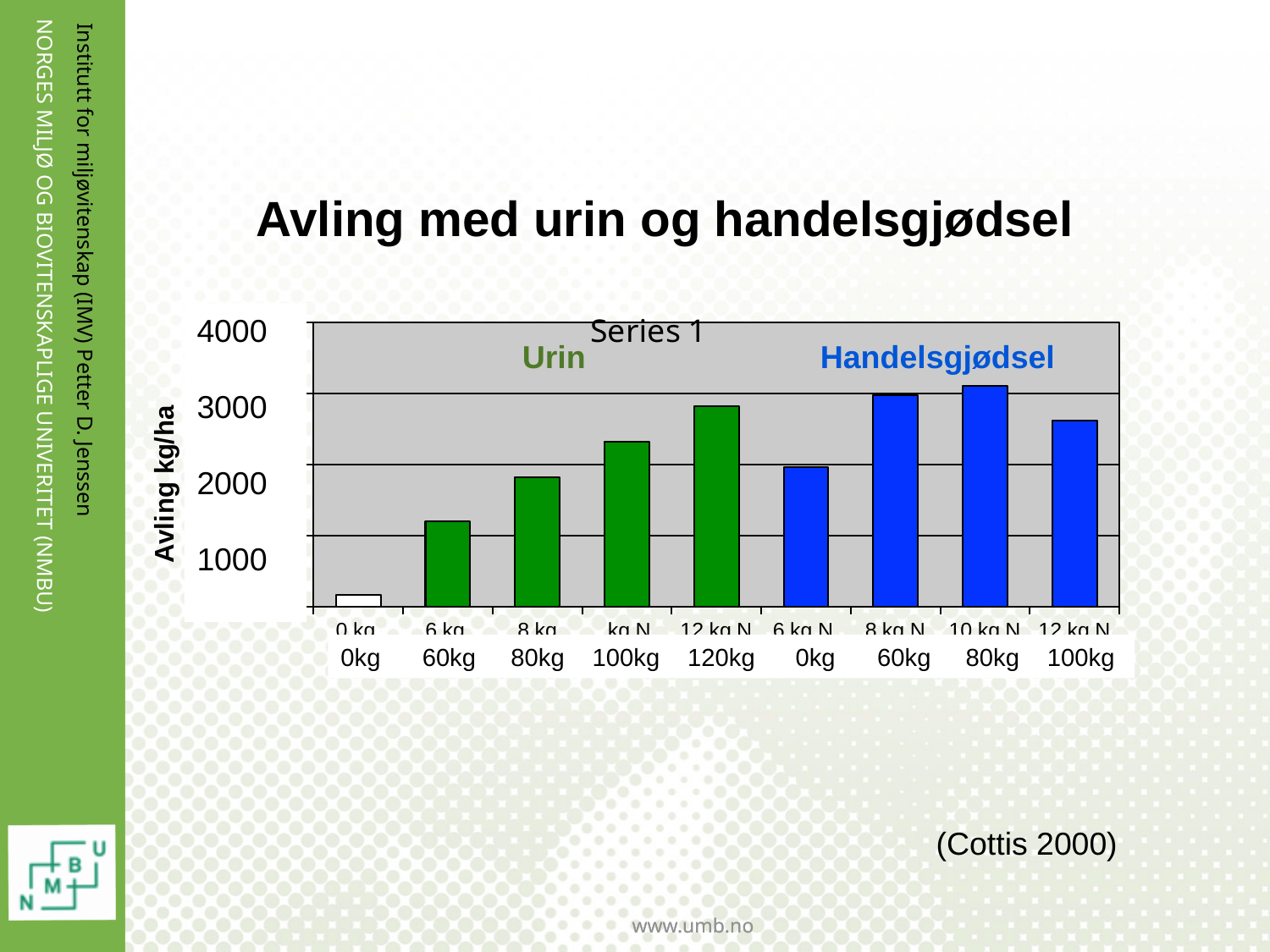
Which is larger, the yield for Urin at 120kg or the yield for Handelsgjødsel at 0kg? Urin at 120kg Is the value for Handelsgjødsel at 80kg greater or less than 3000? greater Is the value for Urin at 60kg greater or less than 2000? less How many bars are plotted in the chart? 9 Is the value for Handelsgjødsel at 100kg greater or less than 3000? less Do the yields in the Urin group rise or fall as the application rate increases from 0kg to 120kg? rise What is the label on the vertical axis of the chart? Avling kg/ha Within the Urin group, which application rate gives the highest yield? 120kg Which bar in the chart is the lowest? 0kg (Urin) What is the title of the chart? Avling med urin og handelsgjødsel What kind of chart is shown on the slide? bar chart